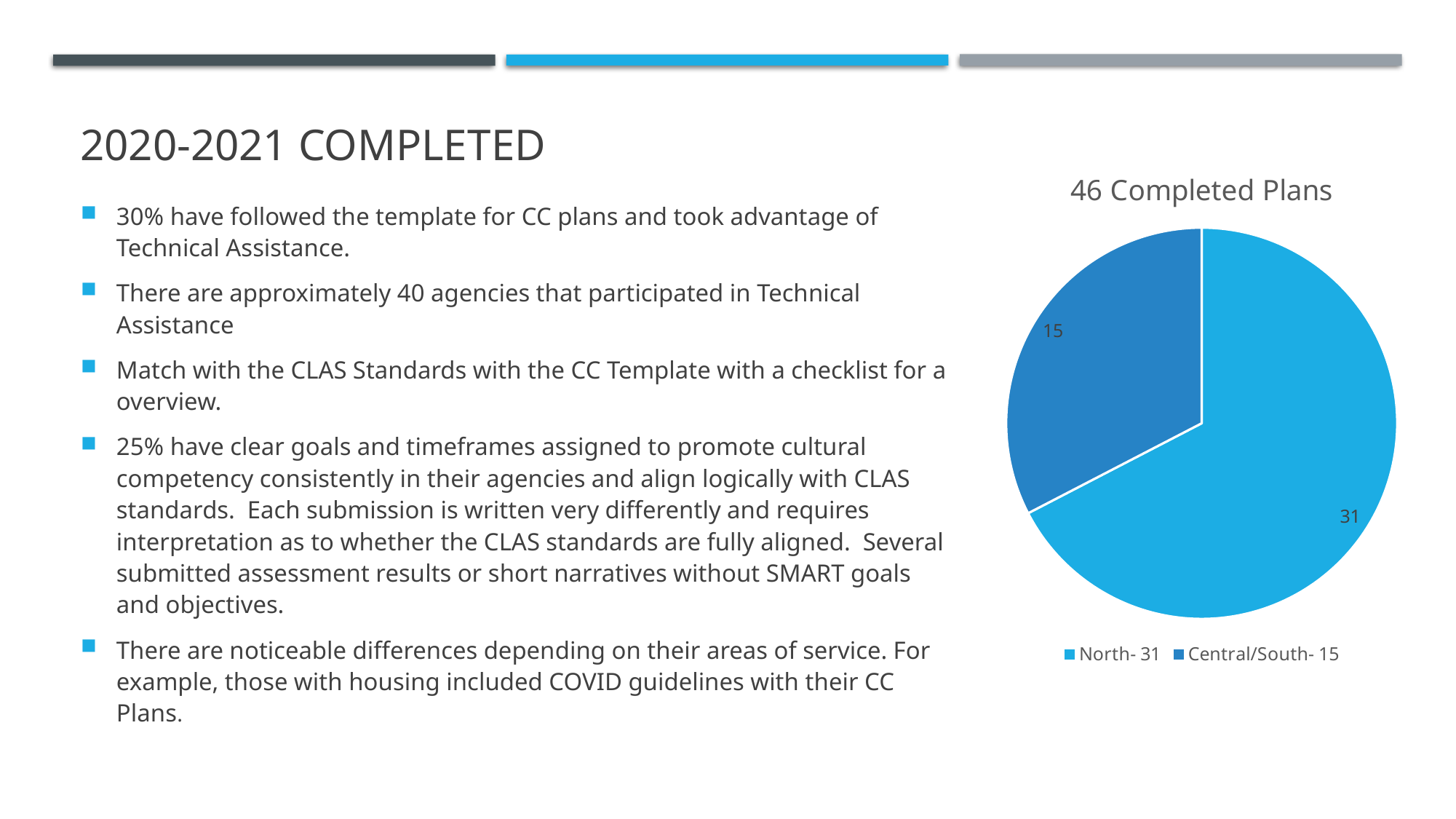
Which is larger, the value for North or the value for Central/South? North Which category has the smallest slice of the pie? Central/South What are the two legend entries of the pie chart? North- 31 and Central/South- 15 How many entries does the legend list? 2 What kind of chart is shown on the slide? pie chart How many slices does the pie chart have? 2 What is the value for North in the pie chart? 31 What is the difference between the North and Central/South values? 16 What is the total of the two slices in the pie chart? 46 Which category has the largest slice of the pie? North What is the title of the chart? 46 Completed Plans What is the value for Central/South in the pie chart? 15